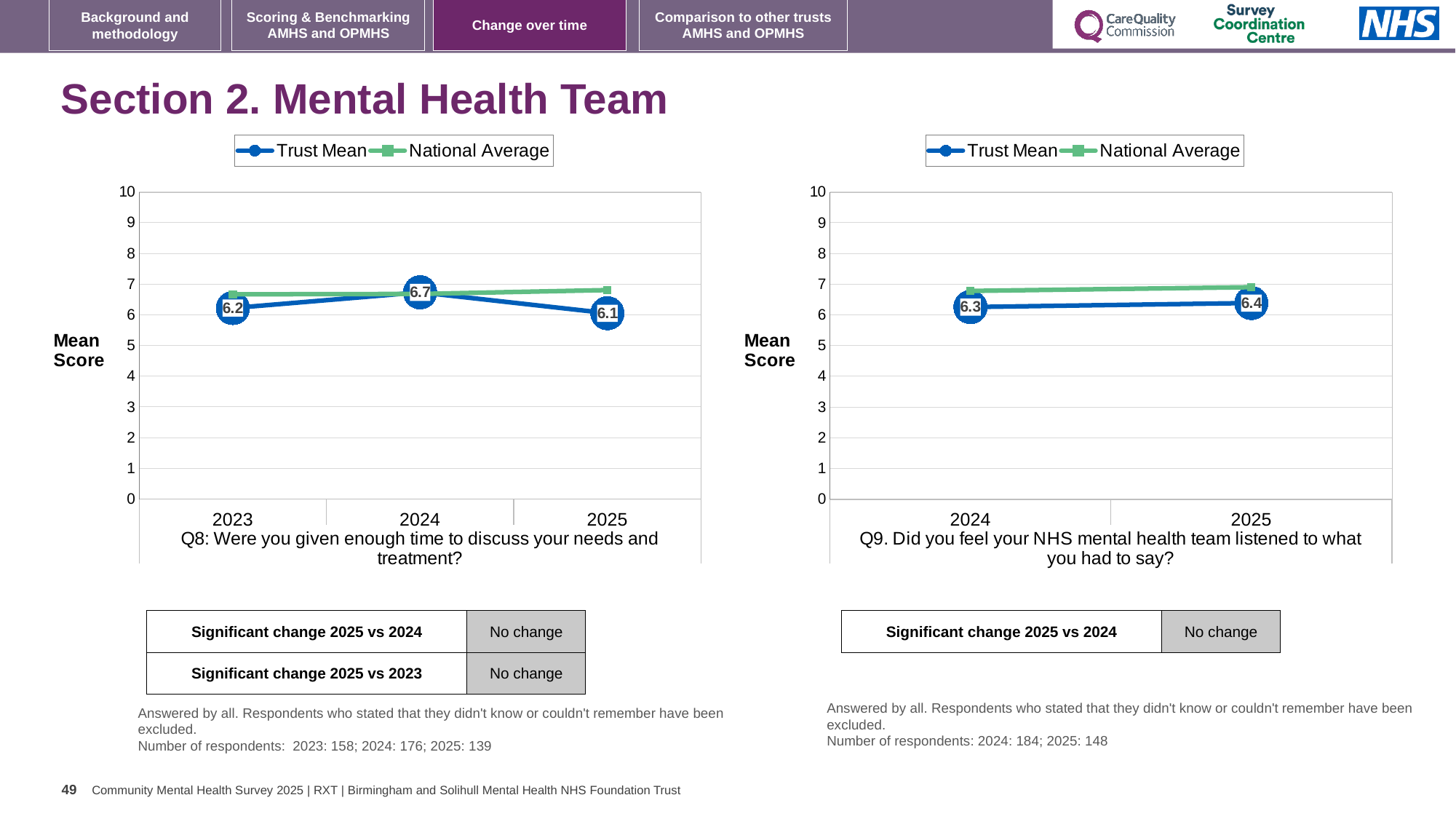
In the Q8 chart (left), what is the Trust Mean for 2024? 6.7 In the Q9 chart (right), what is the Trust Mean for 2024? 6.3 How many years are plotted on the x axis of the Q9 chart (right)? 2 In the Q8 chart (left), which year has the highest Trust Mean? 2024 In the Q8 chart (left), what is the difference between the Trust Mean for 2024 and 2025? 0.6 In the Q8 chart (left), what is the Trust Mean for 2025? 6.1 What type of chart is used for Q8 (left)? Line chart How many series does the legend of the Q8 chart (left) list? 2 In the Q9 chart (right), is the Trust Mean higher in 2024 or 2025? 2025 In the Q9 chart (right), does the Trust Mean rise or fall from 2024 to 2025? Rise In the Q8 chart (left), is the National Average for 2025 greater or less than 6? greater In the Q8 chart (left), which year has the lowest Trust Mean? 2025